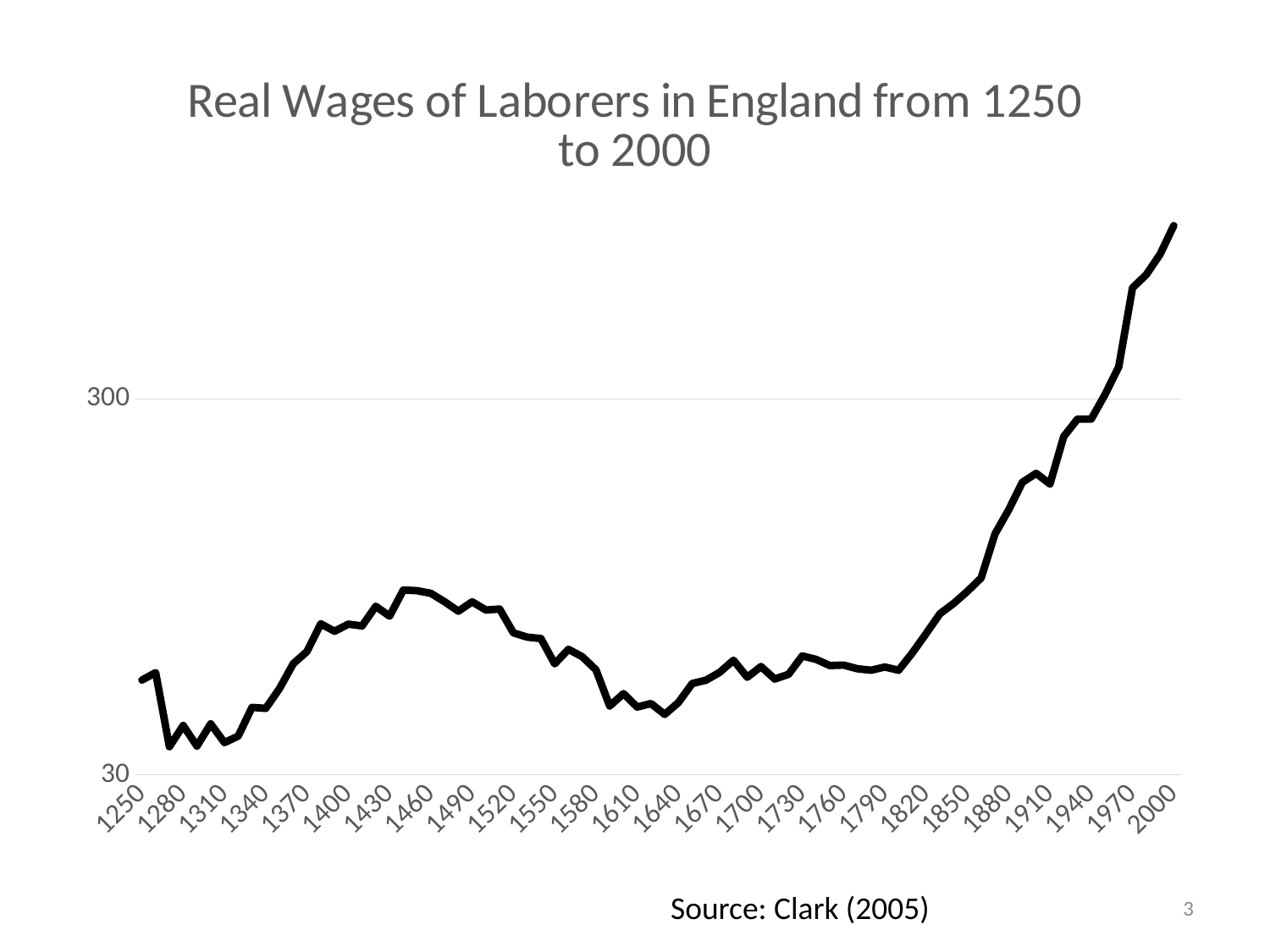
Is the value for 2000 greater or less than 300? greater Which year has the highest real wage value on the chart? 2000 Which has the higher value, 1460 or 1610? 1460 Which has the higher value, 1250 or 2000? 2000 What kind of chart is shown on the slide? Line chart Do the values rise or fall between 1460 and 1610? fall What source is cited for the chart? Clark (2005) What is the title of the chart? Real Wages of Laborers in England from 1250 to 2000 Is the value for 1460 greater or less than 300? less Do the values rise or fall between 1820 and 2000? rise How many year labels are shown on the x axis? 26 Is the value for 1280 greater or less than 300? less